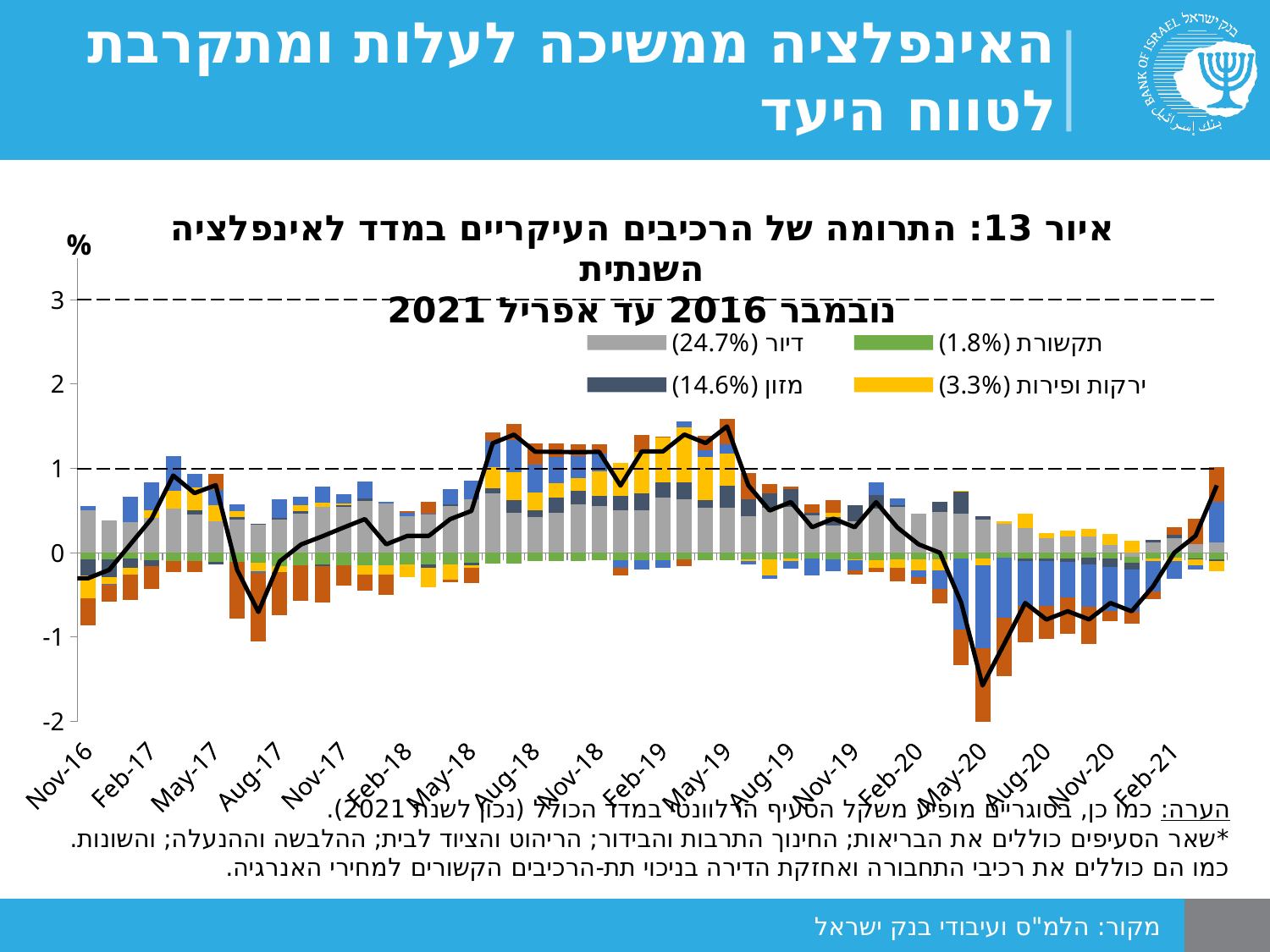
Is the black line at Aug-18 higher or lower than at Aug-20? higher How many series are listed in the chart's legend? 4 What type of chart is shown on the slide? Stacked bar chart with a line What weight is shown in the legend for דיור? 24.7% Is the value of the black line at Aug-18 greater or less than 1? greater Which colour represents דיור in the chart? Gray What weight is shown in the legend for תקשורת? 1.8% Does the black line rise or fall between Feb-20 and May-20? fall What weight is shown in the legend for ירקות ופירות? 3.3% What is the title of the chart (figure number)? איור 13: התרומה של הרכיבים העיקריים במדד לאינפלציה השנתית, נובמבר 2016 עד אפריל 2021 What weight is shown in the legend for מזון? 14.6% Is the value of the black line at May-20 greater or less than -1? less